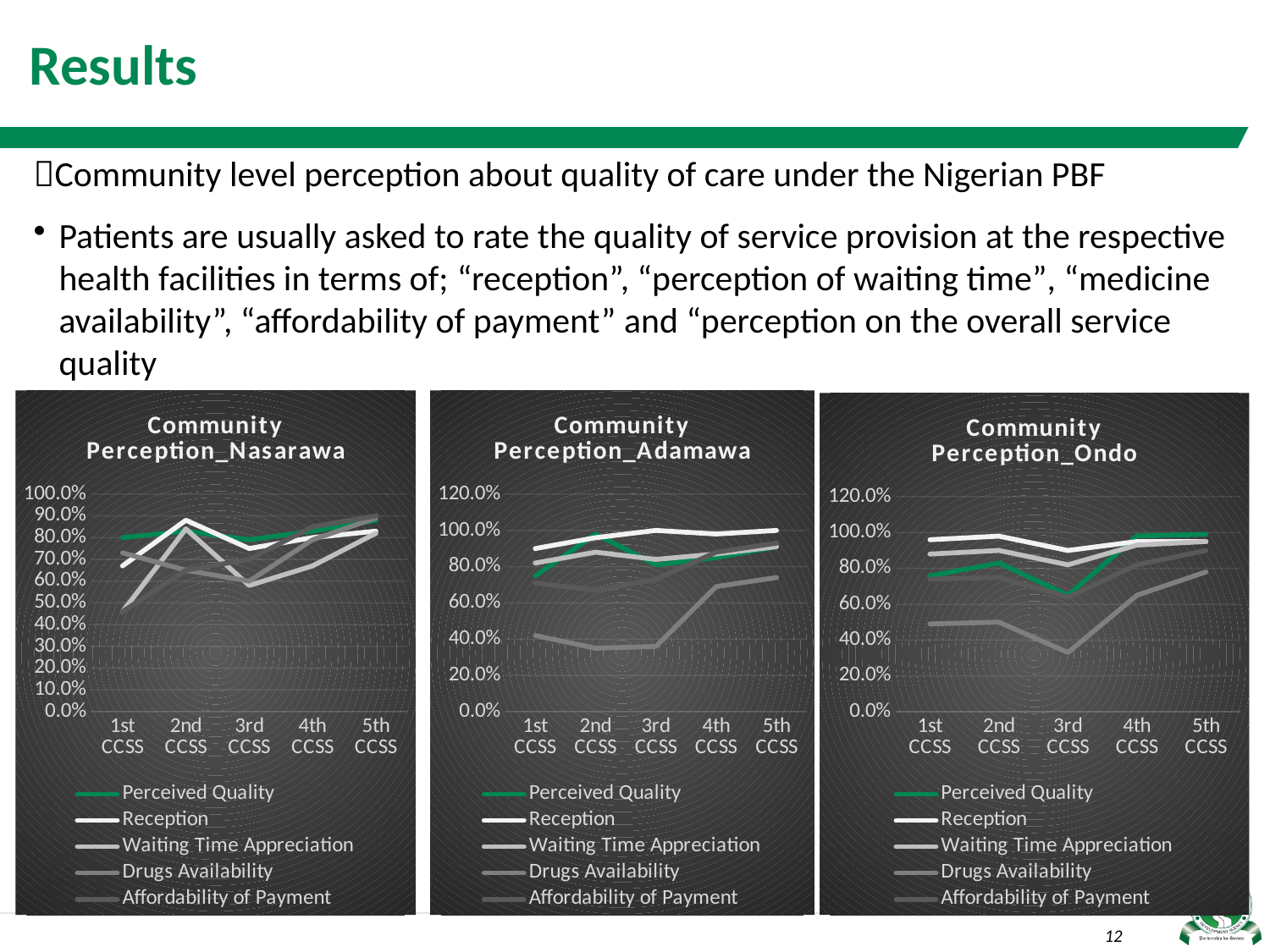
In the Community Perception_Adamawa chart, is the Reception value at 3rd CCSS greater or less than 80.0%? greater In the Community Perception_Ondo chart, does the Perceived Quality line rise or fall from 3rd CCSS to 5th CCSS? rise What is the title of the chart on the right of the slide? Community Perception_Ondo In the Community Perception_Adamawa chart, is the Perceived Quality value at 2nd CCSS greater or less than 80.0%? greater What kind of chart is the Community Perception_Nasarawa chart? line chart In the Community Perception_Ondo chart, at 3rd CCSS, which is larger: Reception or Perceived Quality? Reception In the Community Perception_Ondo chart, is the Perceived Quality value at 3rd CCSS greater or less than 80.0%? less In the Community Perception_Nasarawa chart, which series is drawn in green? Perceived Quality How many series does the legend of the Community Perception_Adamawa chart list? 5 How many categories are shown on the x axis of the Community Perception_Ondo chart? 5